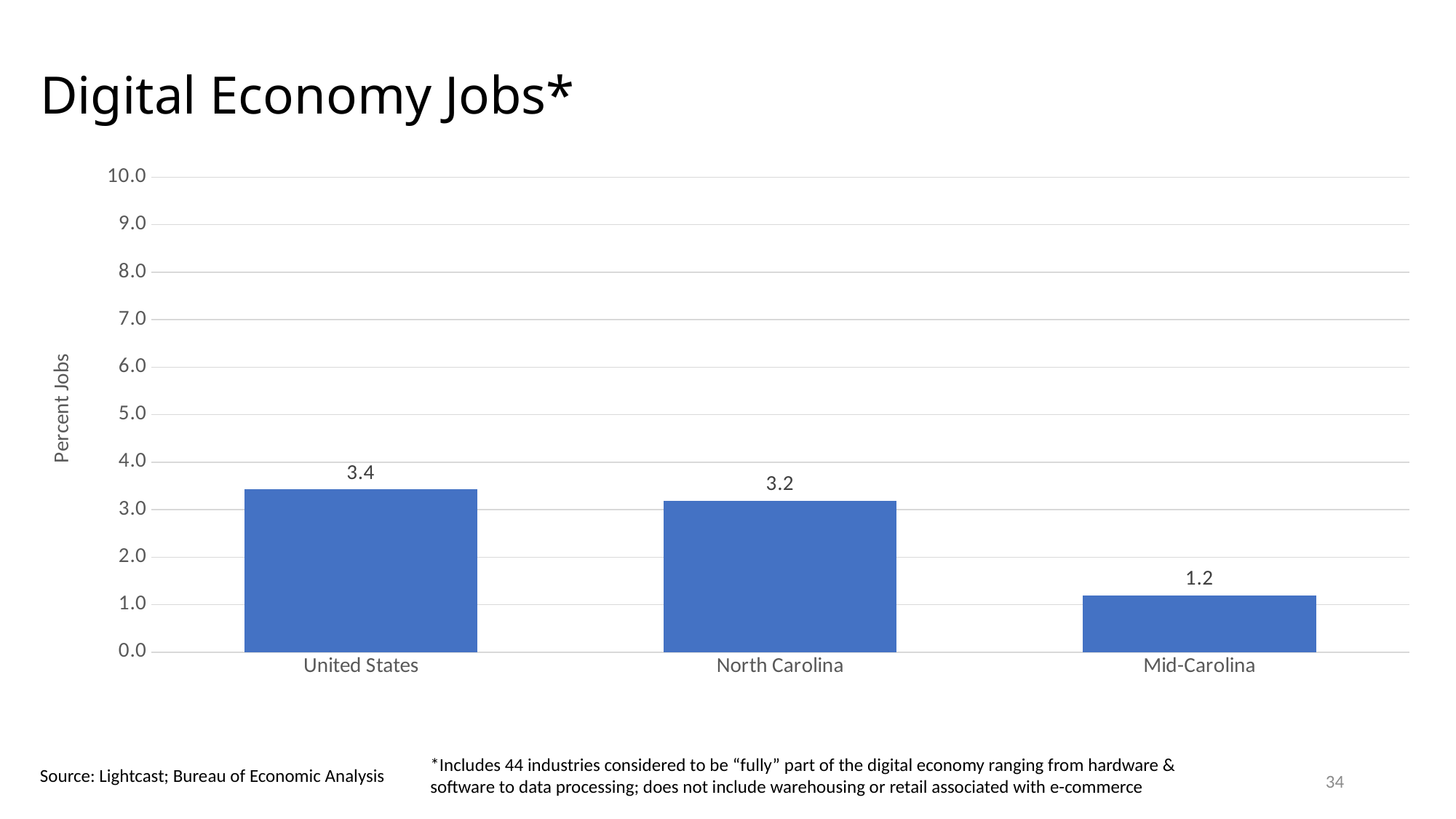
What is the value for United States? 3.4 What is the difference between the values for United States and Mid-Carolina? 2.2 Which category has the lowest value? Mid-Carolina What is the label on the vertical axis of the chart? Percent Jobs Is the value for Mid-Carolina greater or less than 2.0? less How many categories are shown on the chart? 3 What is the value for North Carolina? 3.2 What kind of chart is shown on the slide? bar chart What is the value for Mid-Carolina? 1.2 Which is larger, the value for North Carolina or the value for Mid-Carolina? North Carolina Which category has the highest value? United States What is the difference between the values for North Carolina and Mid-Carolina? 2.0